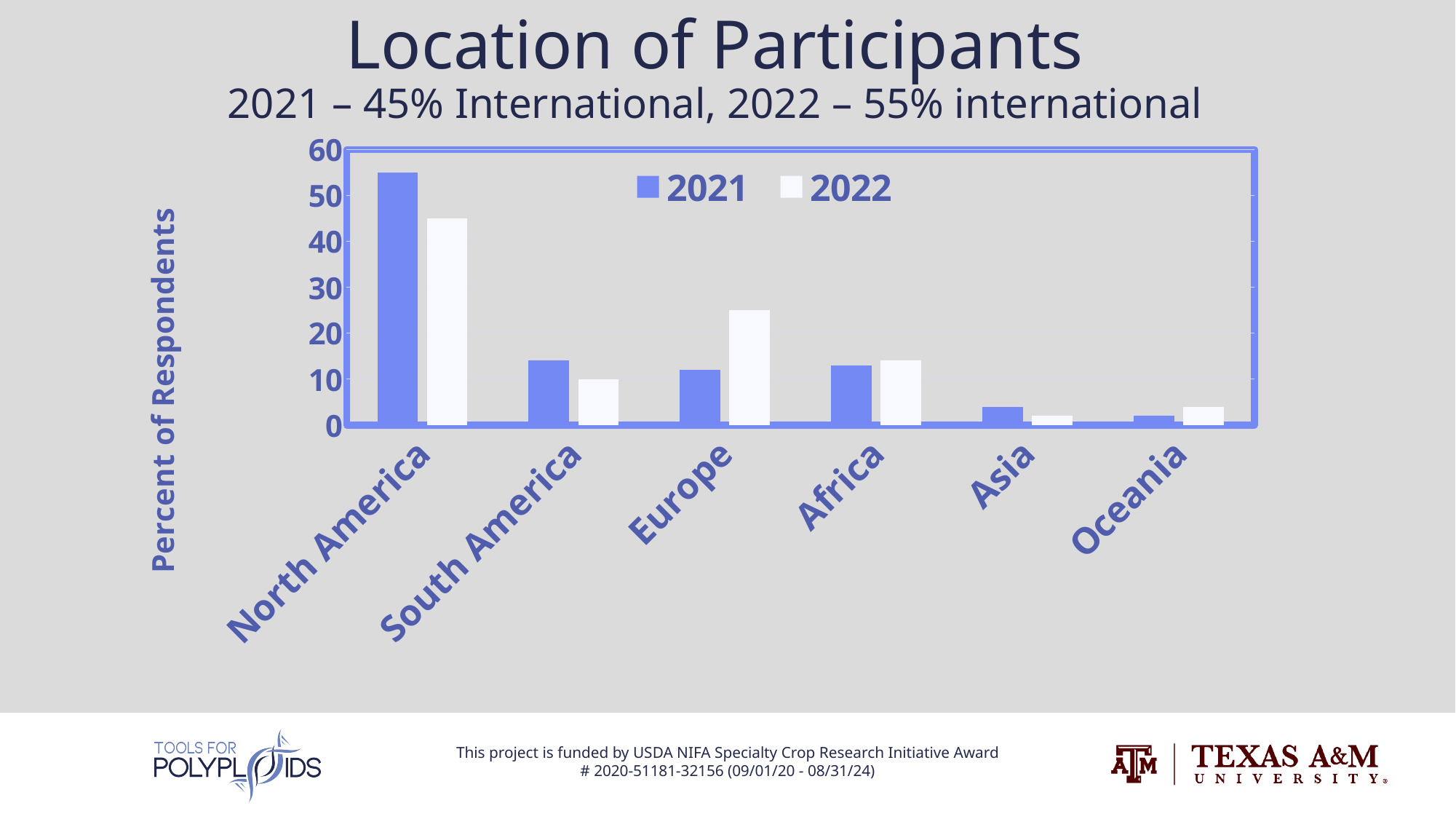
What is the title of the chart? Location of Participants For Europe, which year has the larger value, 2021 or 2022? 2022 How many regions are shown on the x axis of the chart? 6 Which region has the highest value for 2022? North America Is the value for Europe in 2022 greater or less than 20? greater Which region has the highest value for 2021? North America Is the value for North America in 2021 greater or less than 50? greater How many series does the chart's legend list? 2 What is the label on the y axis of the chart? Percent of Respondents For North America, which year has the larger value, 2021 or 2022? 2021 Is the value for Asia in 2021 greater or less than 10? less What kind of chart is shown on the slide? bar chart